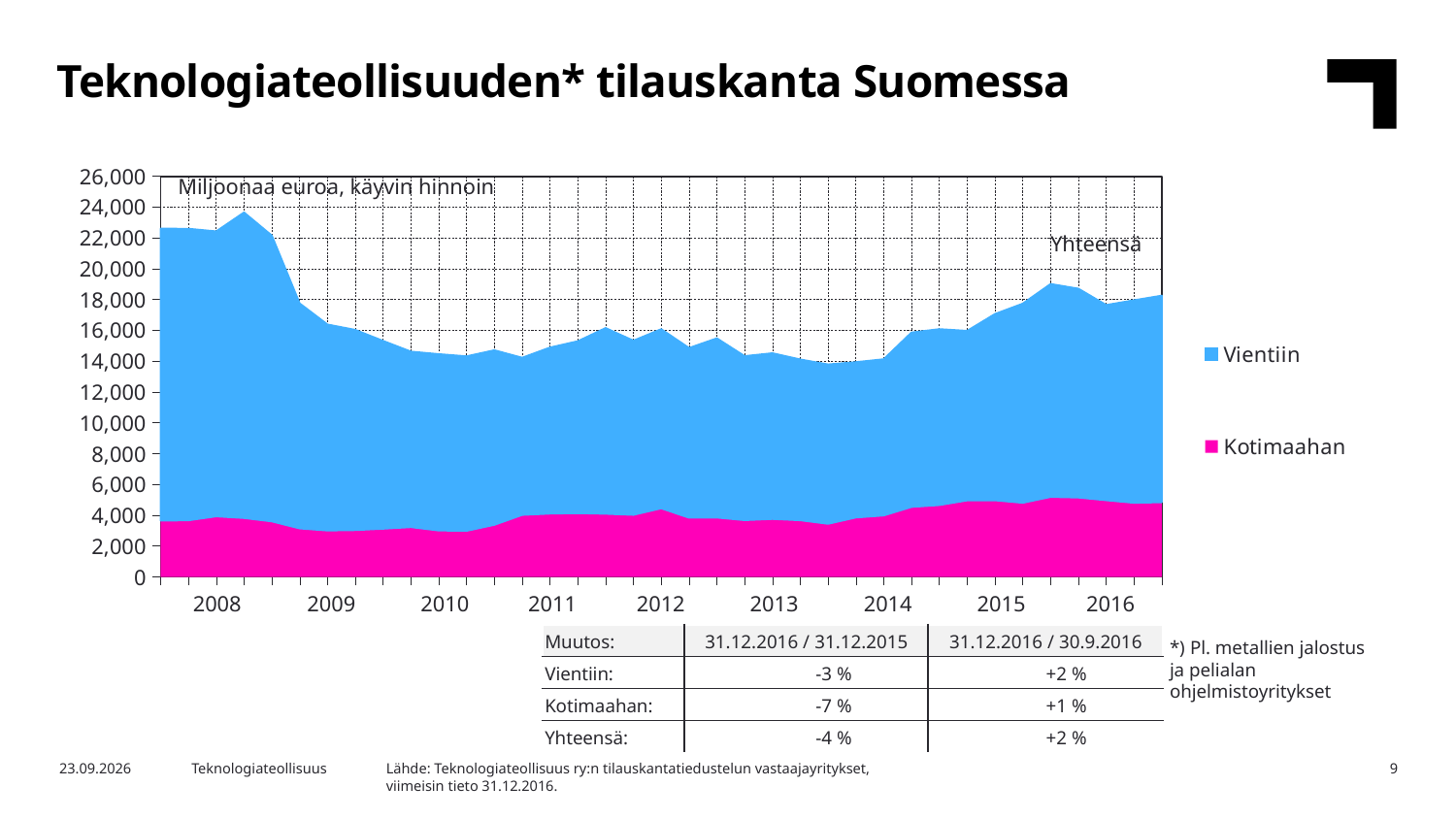
According to the table below the chart, what is the change in Vientiin for 31.12.2016 / 31.12.2015? -3 % How many series does the chart legend list? 2 Which series is larger throughout the chart, Vientiin or Kotimaahan? Vientiin Is the Kotimaahan value in 2010 greater or less than 4,000? less Does the total order backlog rise or fall from 2008 to 2010? fall How many years are labelled on the x axis of the chart? 9 Is the total order backlog (Yhteensä) in 2013 greater or less than 16,000? less What are the two series named in the chart legend? Vientiin and Kotimaahan Is the total order backlog (Yhteensä) at the end of 2016 greater or less than 20,000? less What kind of chart is shown on the slide? Area chart What is the title of the slide containing the chart? Teknologiateollisuuden* tilauskanta Suomessa